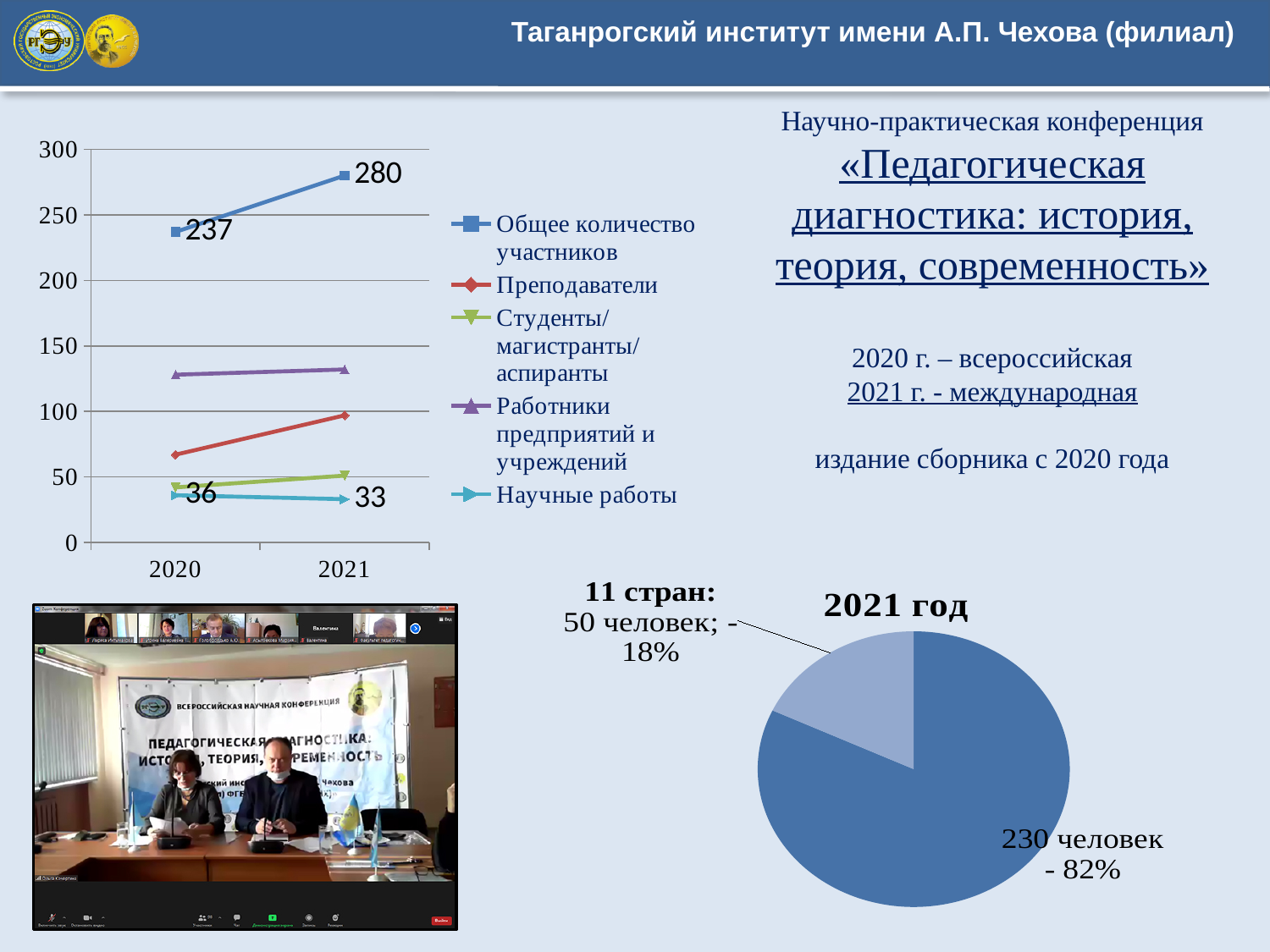
What kind of chart is the chart titled 2021 год? pie chart How many series does the legend of the line chart on the left list? 5 In the line chart on the left, by how much did Общее количество участников increase from 2020 to 2021? 43 In the pie chart titled 2021 год, how many slices are there? 2 In the line chart on the left, what is the value for Общее количество участников in 2020? 237 In the line chart on the left, what is the value for Общее количество участников in 2021? 280 In the pie chart titled 2021 год, what share does the 230 человек slice represent? 82% In the line chart on the left, does the value for Научные работы rise or fall from 2020 to 2021? fall In the line chart on the left, is the value for Преподаватели in 2020 greater or less than 100? less In the line chart on the left, is the value for Работники предприятий и учреждений in 2020 greater or less than 100? greater What kind of chart is the chart on the left of the slide? line chart In the line chart on the left, what is the value for Научные работы in 2020? 36